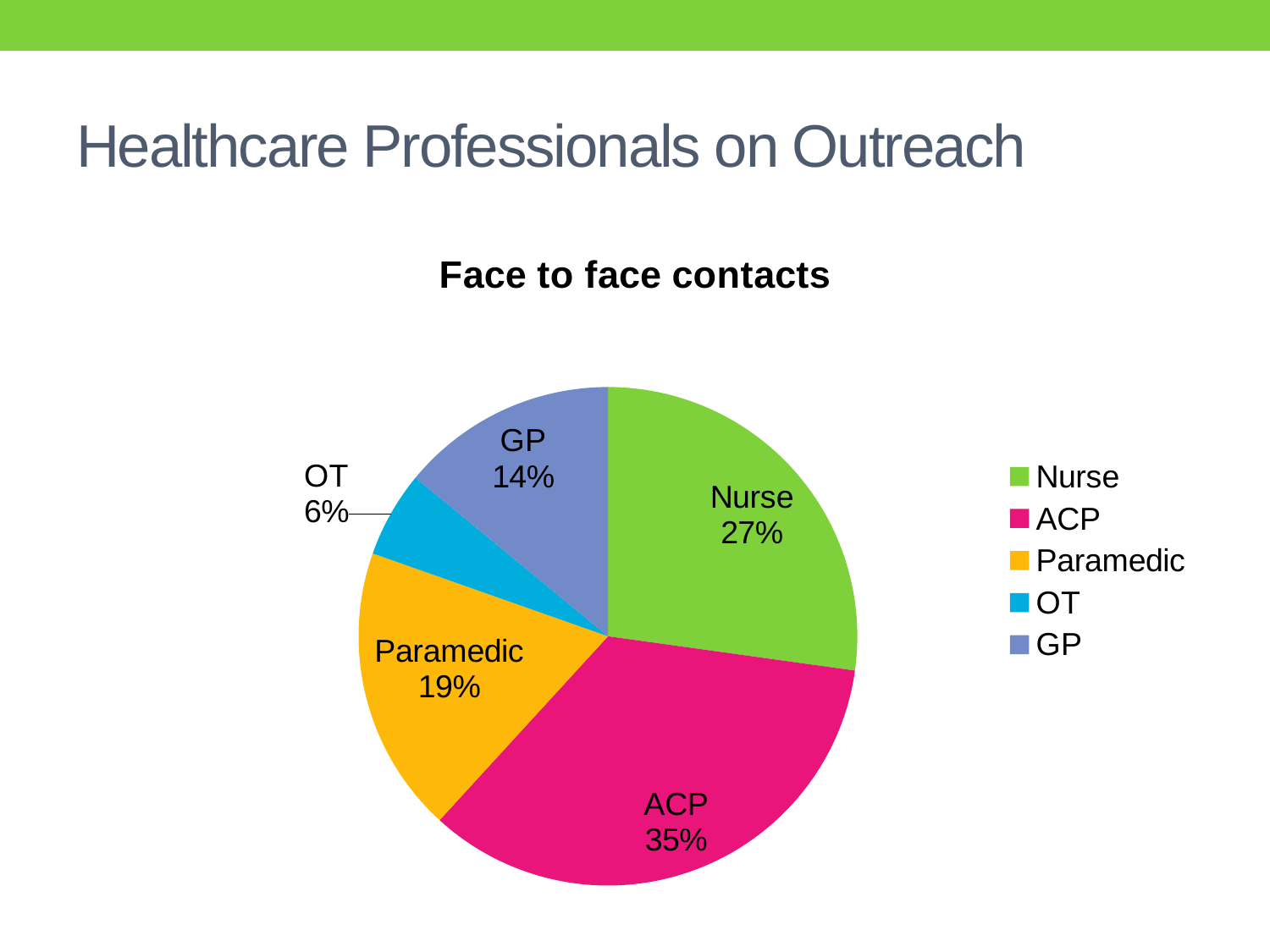
What is the title of the chart? Face to face contacts What share of face to face contacts is attributed to Paramedic? 19% What is the difference in percentage points between the ACP and Nurse shares? 8 Which healthcare professional has the largest share of face to face contacts? ACP What percentage of face to face contacts is attributed to ACP? 35% How many categories are shown in the pie chart? 5 Which healthcare professional has the smallest share of face to face contacts? OT What type of chart is shown on the slide? Pie chart Which has a larger share of face to face contacts, Paramedic or GP? Paramedic What share of face to face contacts is attributed to Nurse? 27% What share of face to face contacts is attributed to GP? 14% What percentage of face to face contacts is attributed to OT? 6%